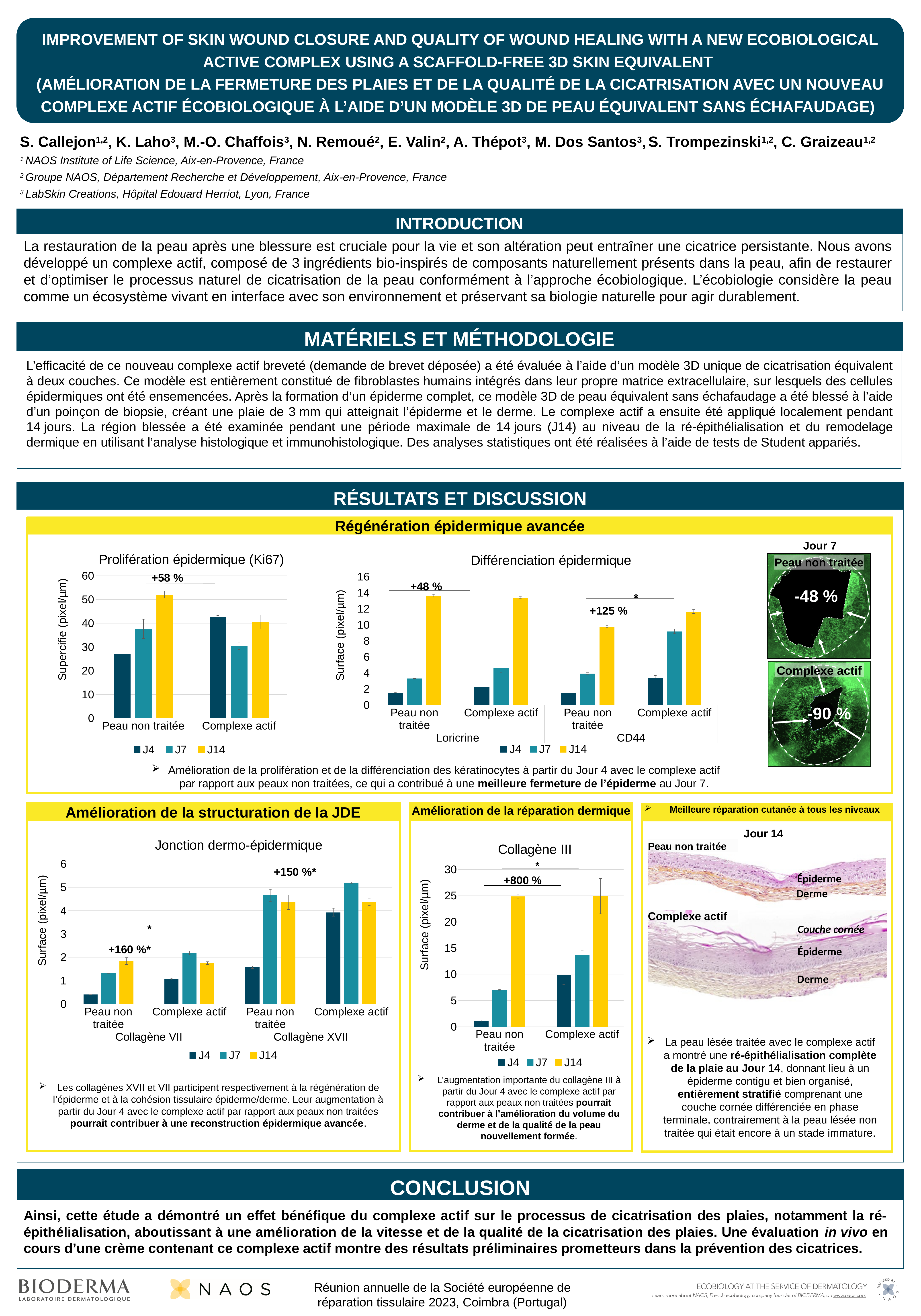
In the 'Différenciation épidermique' chart, what percentage increase is annotated for CD44? +125 % In the 'Prolifération épidermique (Ki67)' chart, what percentage increase is annotated above the Peau non traitée bars? +58 % In the 'Collagène III' chart, is the J4 value for Peau non traitée greater or less than 5? less In the 'Collagène III' chart, is the J7 value for Complexe actif greater or less than 10? greater In the 'Différenciation épidermique' chart, is the J14 value for Loricrine Peau non traitée greater or less than 12? greater In the 'Prolifération épidermique (Ki67)' chart, how many series does the legend list? 3 In the 'Jonction dermo-épidermique' chart, which bar is the lowest? J4 for Peau non traitée, Collagène VII In the 'Prolifération épidermique (Ki67)' chart, which bar is the highest? J14 for Peau non traitée In the 'Jonction dermo-épidermique' chart, which bar is the highest? J7 for Complexe actif, Collagène XVII What kind of chart is the 'Prolifération épidermique (Ki67)' chart? bar chart In the 'Différenciation épidermique' chart, for CD44 at J14, which is larger: Peau non traitée or Complexe actif? Complexe actif